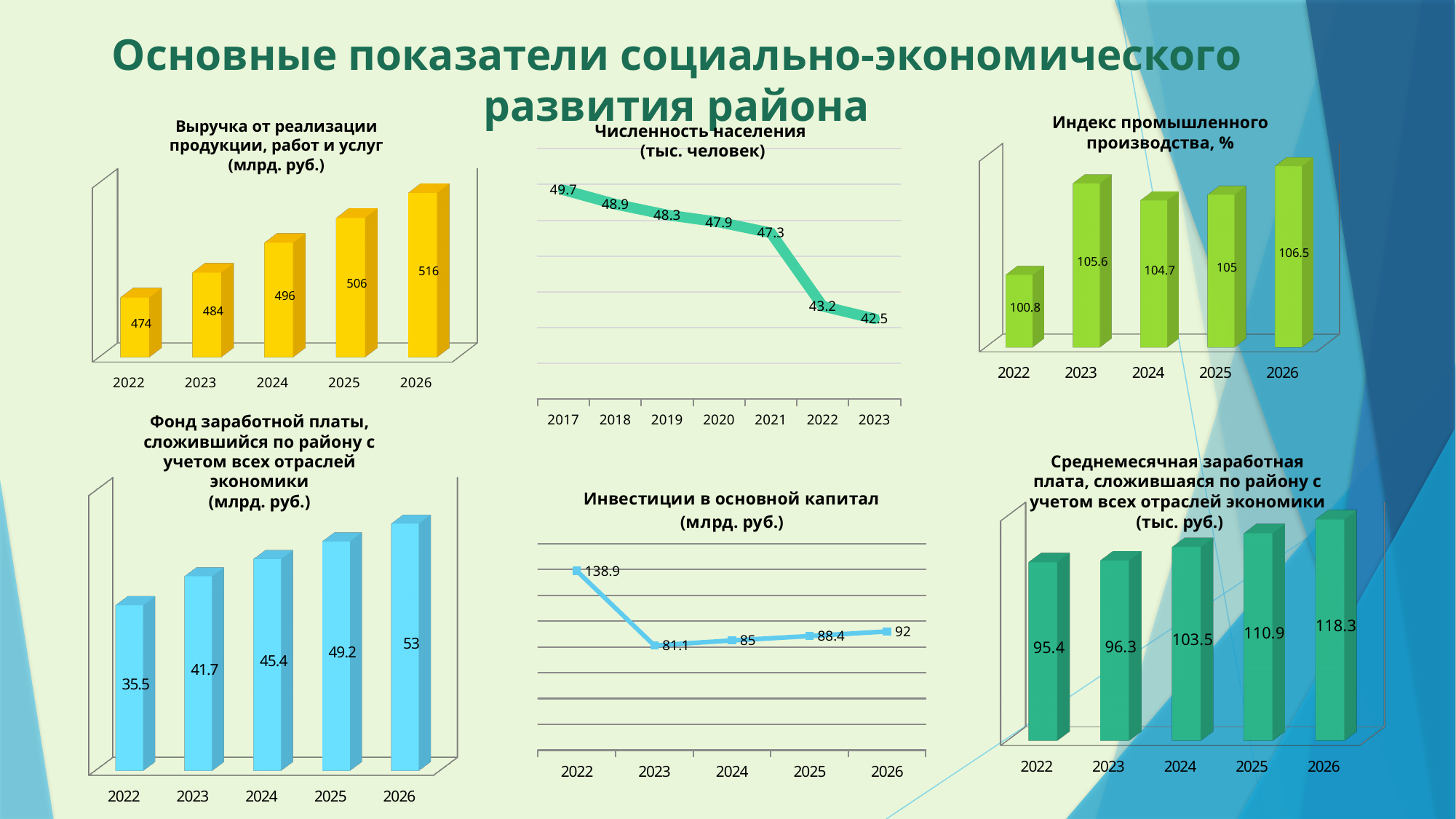
In the chart 'Среднемесячная заработная плата, сложившаяся по району с учетом всех отраслей экономики (тыс. руб.)', what is the value for 2026? 118.3 How many charts are shown on the slide? 6 In the chart 'Индекс промышленного производства, %', which year has the lowest value? 2022 In the chart 'Инвестиции в основной капитал (млрд. руб.)', which year has the highest value? 2022 In the chart 'Численность населения (тыс. человек)', what is the value for 2021? 47.3 In the chart 'Индекс промышленного производства, %', which is larger: the value for 2023 or the value for 2024? 2023 In the chart 'Выручка от реализации продукции, работ и услуг (млрд. руб.)', what is the difference between the 2026 and 2022 values? 42 What type of chart is 'Инвестиции в основной капитал (млрд. руб.)'? line chart In the chart 'Фонд заработной платы, сложившийся по району с учетом всех отраслей экономики (млрд. руб.)', what is the value for 2025? 49.2 How many data points are plotted in the chart 'Численность населения (тыс. человек)'? 7 In the chart 'Выручка от реализации продукции, работ и услуг (млрд. руб.)', what is the value for 2024? 496 In the chart 'Численность населения (тыс. человек)', do the values rise or fall from 2017 to 2023? fall